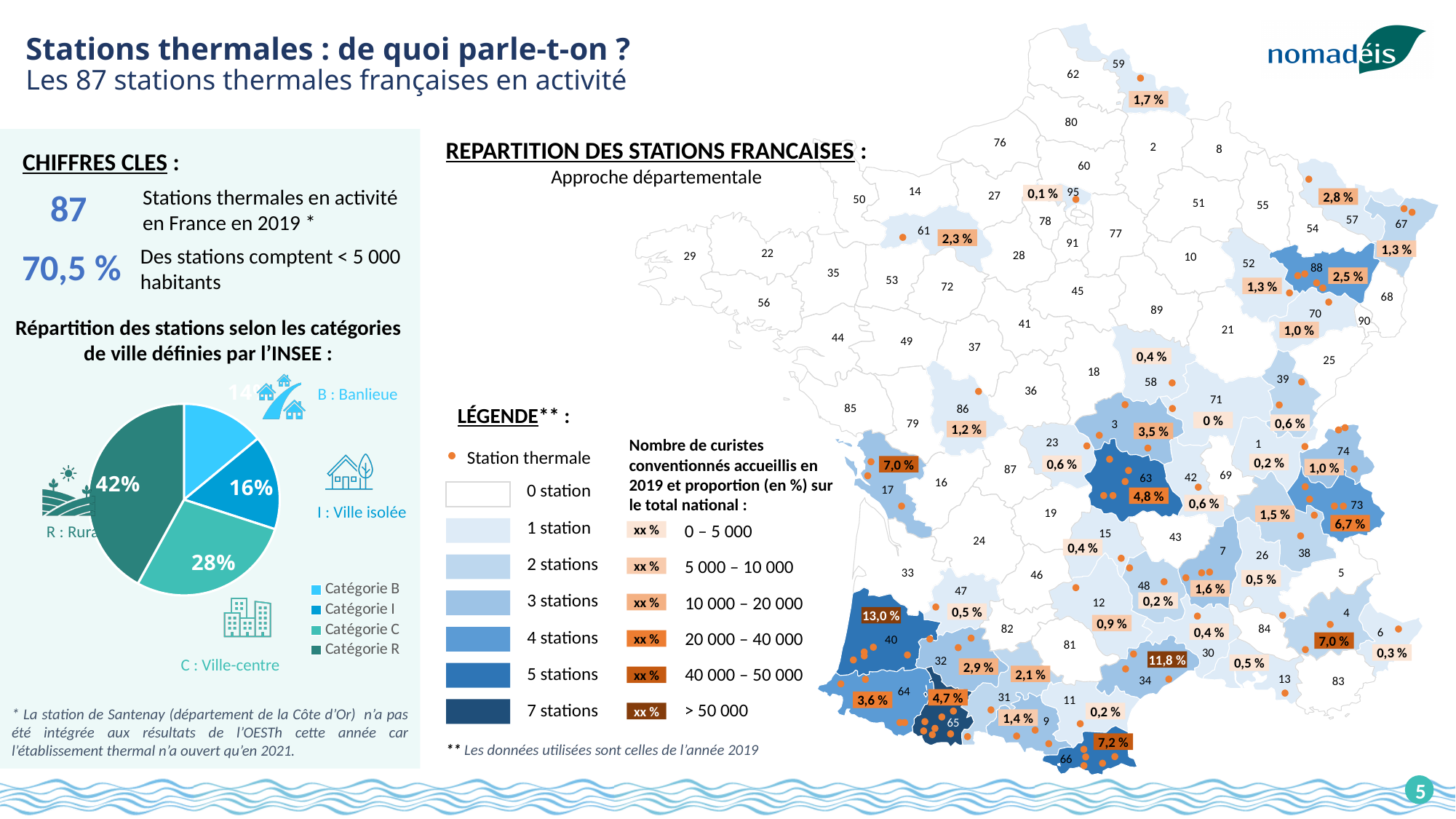
In the pie chart, what share of stations is in Catégorie I (Ville isolée)? 16% What kind of chart shows the distribution of stations by INSEE town category? pie chart Which category has the largest slice in the pie chart? Catégorie R In the pie chart, which is larger: Catégorie I or Catégorie B? Catégorie I How many entries does the pie chart legend list? 4 What is the combined share of Catégorie B and Catégorie I in the pie chart? 30% What is the difference in percentage points between Catégorie R and Catégorie C in the pie chart? 14 In the pie chart, what share of stations is in Catégorie B (Banlieue)? 14% How many categories does the pie chart show? 4 Which category has the smallest slice in the pie chart? Catégorie B In the pie chart, what share of stations is in Catégorie R (Rural)? 42% In the pie chart, what share of stations is in Catégorie C (Ville-centre)? 28%